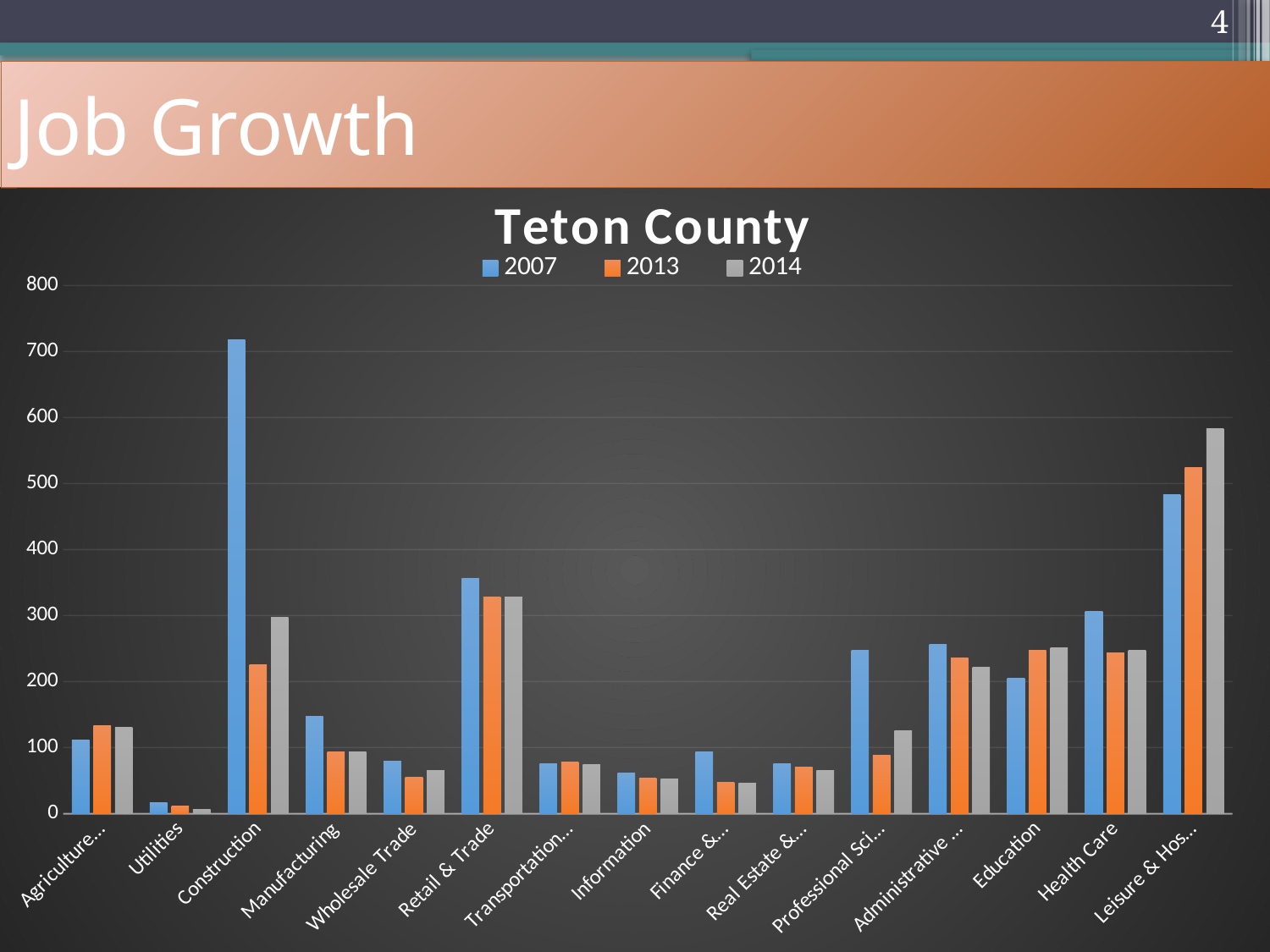
How many industry categories are shown along the x axis of the Teton County chart? 15 Is the 2007 value for Construction greater or less than 600? greater What kind of chart is shown on the slide? Bar chart Which colour represents the 2013 series in the Teton County chart? Orange Is the 2007 value for Retail & Trade greater or less than 300? greater Is the 2013 value for Professional Sci... greater or less than 200? less Which category has the highest 2014 value in the Teton County chart? Leisure & Hos... Which is larger in 2007: Health Care or Education? Health Care Which category has the highest 2007 value in the Teton County chart? Construction How many series does the legend of the Teton County chart list? 3 Which category has the lowest 2007 value in the Teton County chart? Utilities